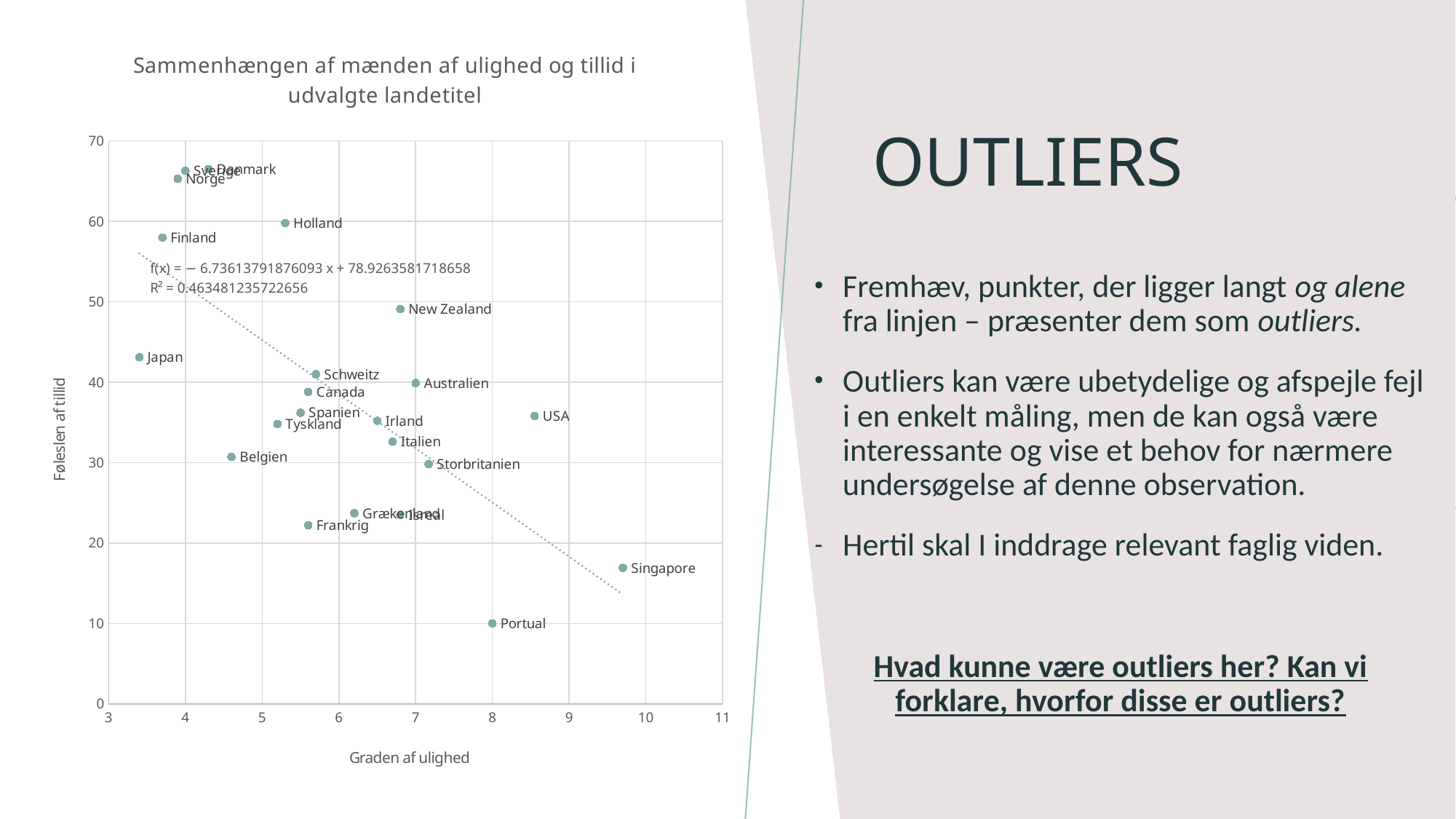
Which country has the highest value on the x axis (Graden af ulighed)? Singapore Which country has the lowest value on the x axis (Graden af ulighed)? Japan What is the title of the chart? Sammenhængen af mænden af ulighed og tillid i udvalgte landetitel Which country has the lowest value on the y axis (Føleslen af tillid)? Portual What is the label of the x axis of the chart? Graden af ulighed Is the y-axis value for USA greater or less than 30? greater Is the y-axis value for Japan greater or less than 40? greater Is the y-axis value for Finland greater or less than 50? greater Do the values generally rise or fall as the x axis (Graden af ulighed) increases? fall Which has a higher y-axis value, Holland or Belgien? Holland What kind of chart is shown on the slide? scatter chart